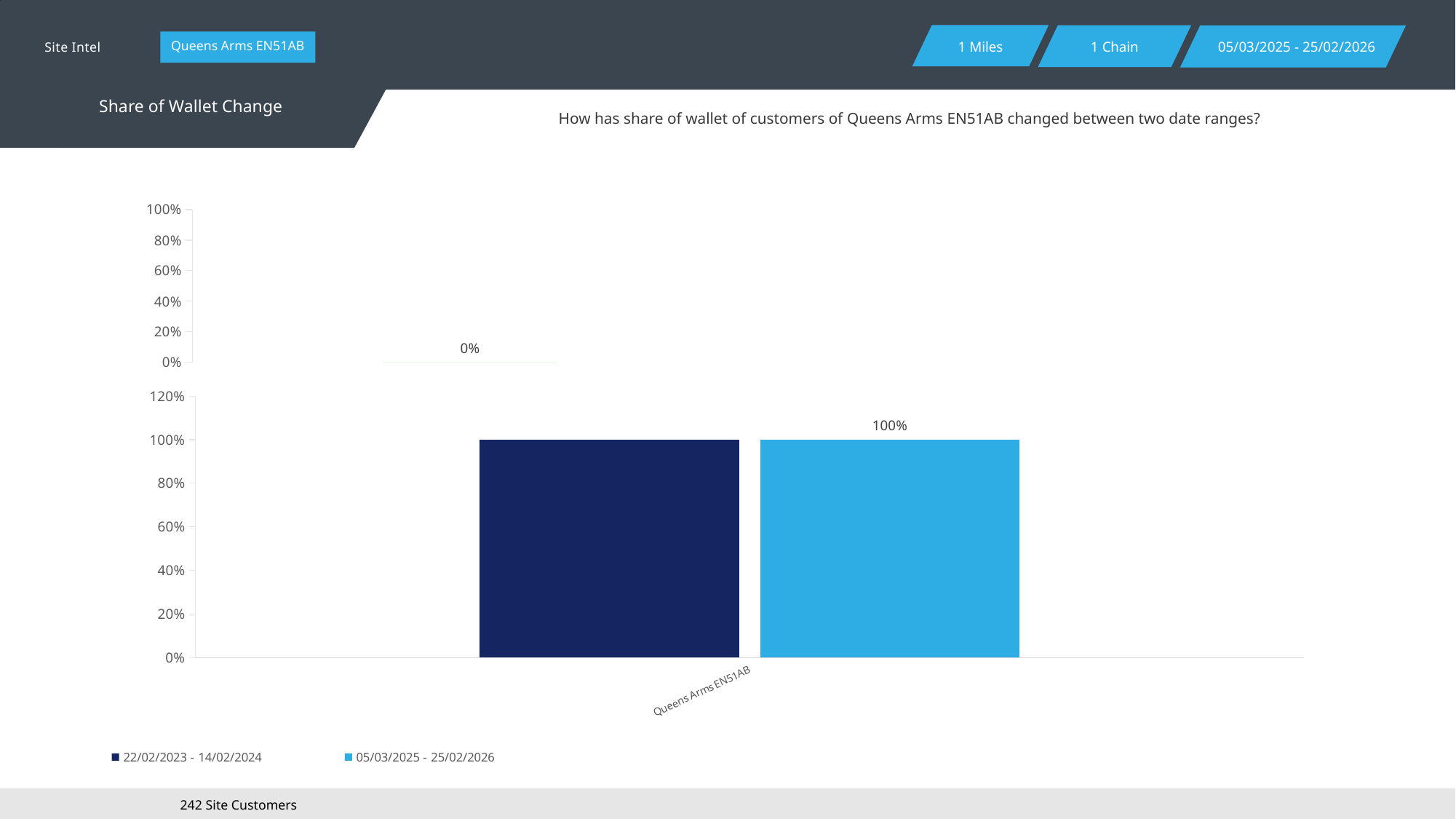
In the top chart, what value is printed as the data label? 0% In the bottom chart, is the value for the 22/02/2023 - 14/02/2024 series greater or less than 80%? greater In the bottom chart, how many series does the legend list? 2 In the bottom chart, what are the two series listed in the legend? 22/02/2023 - 14/02/2024 and 05/03/2025 - 25/02/2026 In the bottom chart, what is the value for the 22/02/2023 - 14/02/2024 series for Queens Arms EN51AB? 100% In the bottom chart, what is the value for the 05/03/2025 - 25/02/2026 series for Queens Arms EN51AB? 100% What kind of chart is the bottom chart on the slide? bar chart In the bottom chart, what is the category label on the x axis? Queens Arms EN51AB In the bottom chart, what colour is the bar for the 05/03/2025 - 25/02/2026 series? light blue In the bottom chart, how many categories are shown on the x axis? 1 In the bottom chart, is the value for the 05/03/2025 - 25/02/2026 series greater or less than 60%? greater In the bottom chart, what is the difference between the 05/03/2025 - 25/02/2026 value and the 22/02/2023 - 14/02/2024 value for Queens Arms EN51AB? 0%